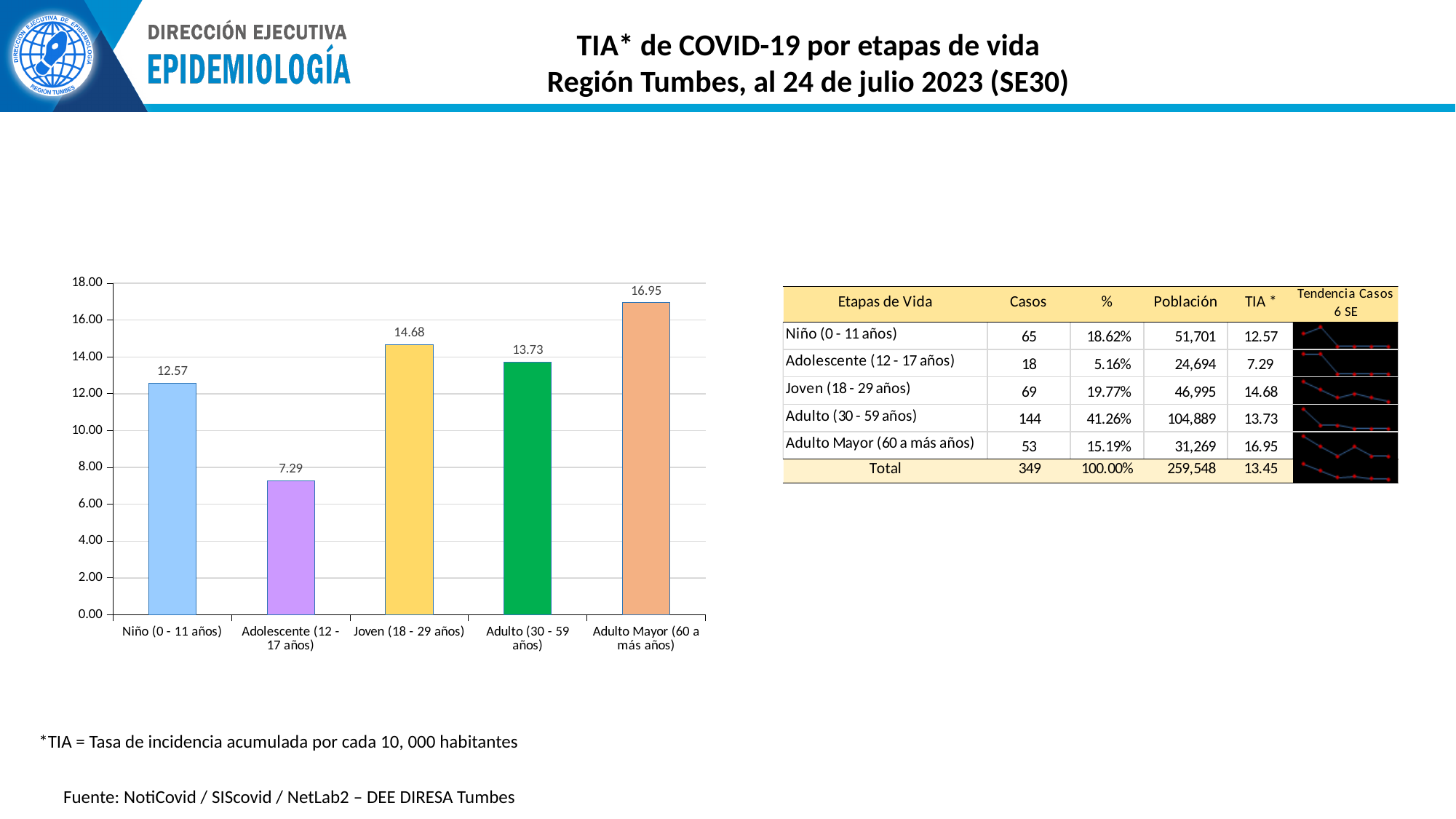
What is the TIA value for Joven (18 - 29 años) in the bar chart? 14.68 What type of chart is used to show TIA by life stage? bar chart What is the TIA value for Adolescente (12 - 17 años) in the bar chart? 7.29 What is the TIA value for Adulto Mayor (60 a más años) in the bar chart? 16.95 What is the difference between the TIA for Adulto Mayor (60 a más años) and Adolescente (12 - 17 años)? 9.66 What is the difference between the TIA for Joven (18 - 29 años) and Niño (0 - 11 años)? 2.11 What is the TIA value for Niño (0 - 11 años) in the bar chart? 12.57 Which has a higher TIA, Joven (18 - 29 años) or Adulto (30 - 59 años)? Joven (18 - 29 años) Which life stage has the lowest TIA in the bar chart? Adolescente (12 - 17 años) Which life stage has the highest TIA in the bar chart? Adulto Mayor (60 a más años) How many life-stage categories are shown in the bar chart? 5 Is the TIA value for Niño (0 - 11 años) greater or less than 12.00? greater